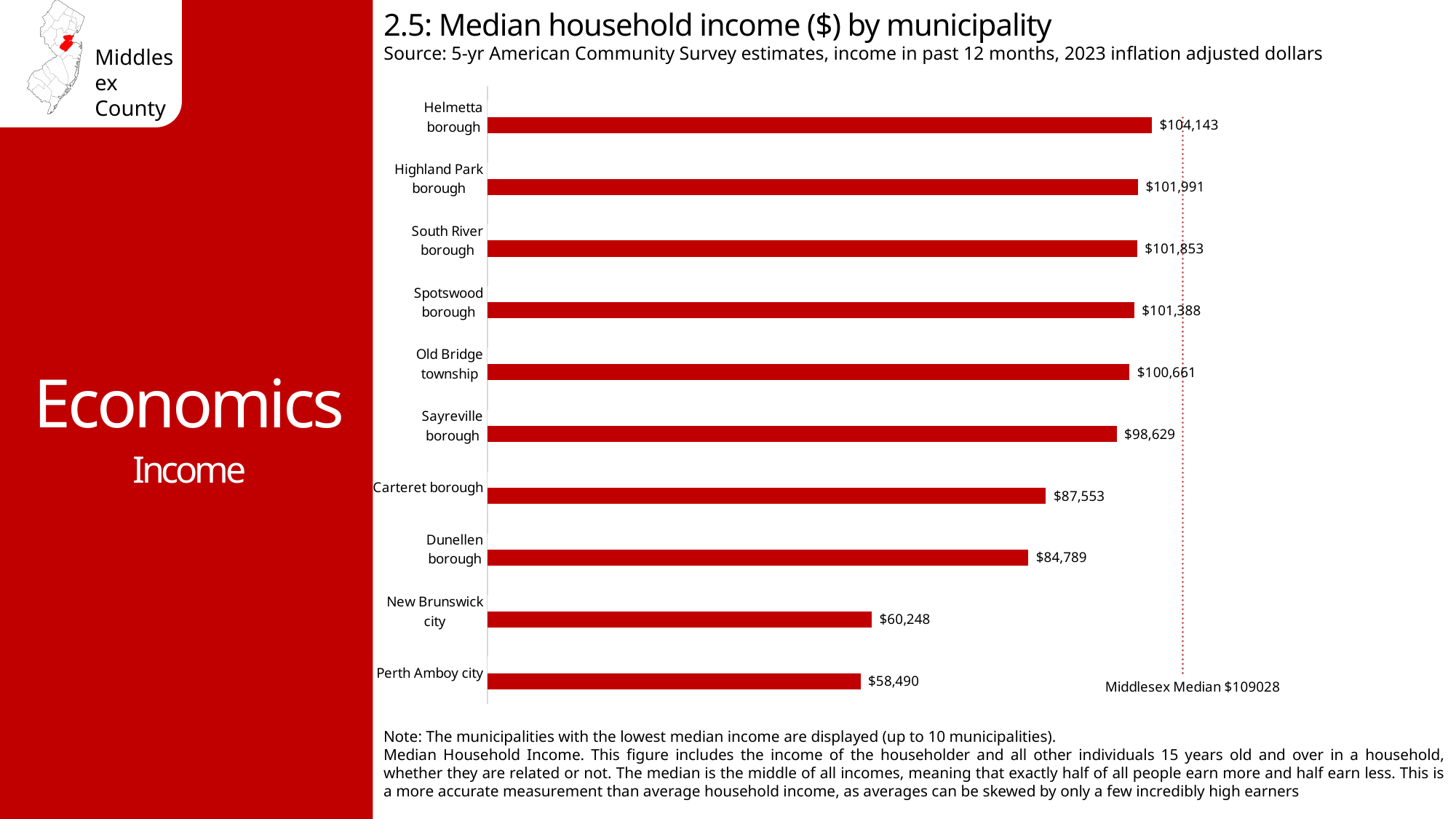
What is the Middlesex median household income indicated by the dotted reference line? $109028 What is the difference in median household income between Helmetta borough and Perth Amboy city? $45,653 Which municipality has the highest median household income shown on the chart? Helmetta borough How many municipalities are shown on the chart? 10 Which municipality has the lowest median household income shown on the chart? Perth Amboy city What is the median household income for Perth Amboy city? $58,490 Which has a higher median household income, Sayreville borough or Carteret borough? Sayreville borough What is the difference in median household income between Carteret borough and Dunellen borough? $2,764 What is the median household income for New Brunswick city? $60,248 What is the median household income for Carteret borough? $87,553 What is the median household income for Helmetta borough? $104,143 What type of chart is used to show median household income by municipality? Bar chart